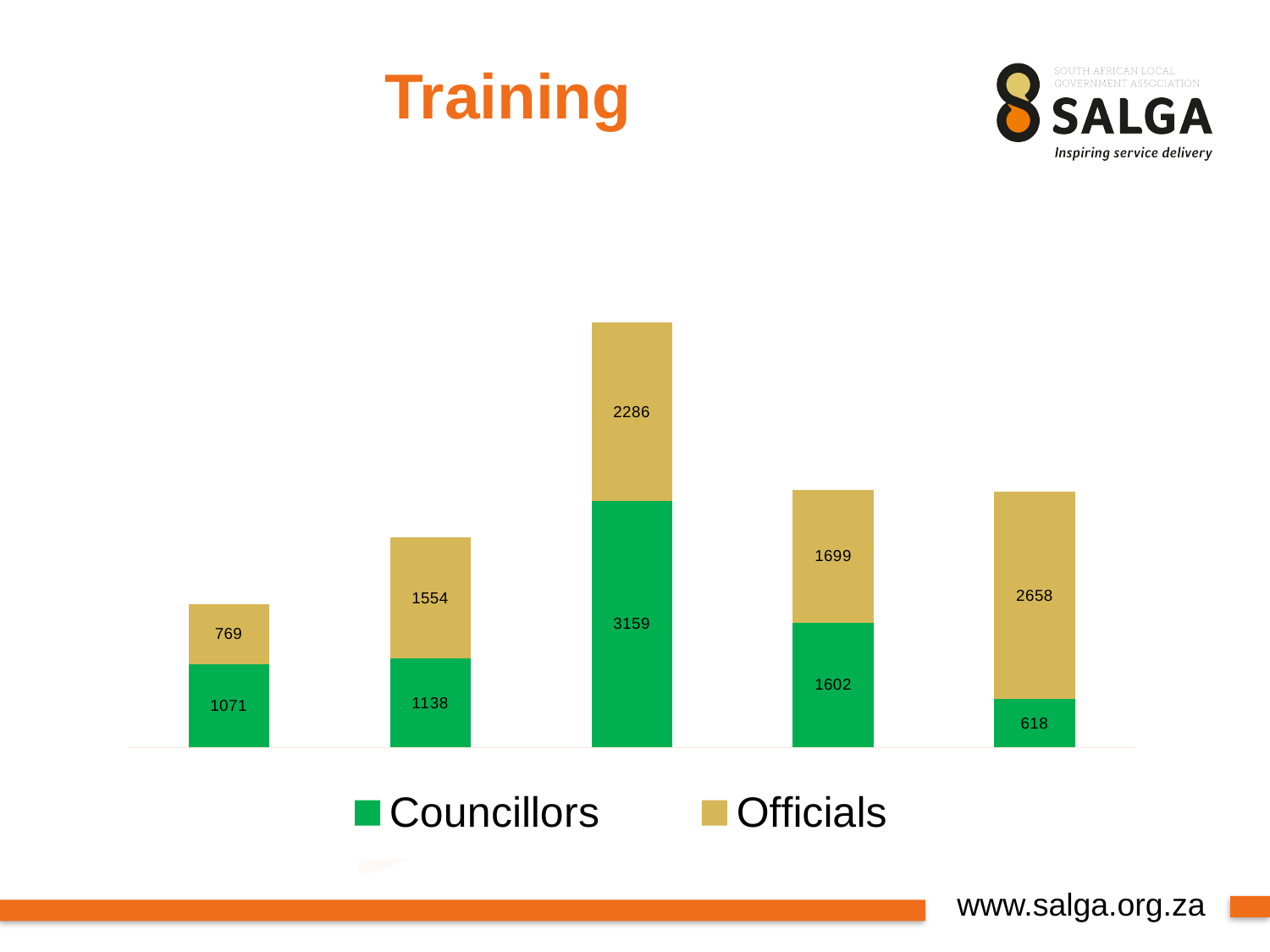
What is the Councillors value for the first (leftmost) bar? 1071 What is the total of the third stacked bar? 5445 How many stacked bars are shown in the chart? 5 Which bar, by position from the left, has the lowest Officials value? the first bar How many series does the legend list? 2 In the fourth bar, which is larger, the Councillors value or the Officials value? Officials Which bar, by position from the left, has the highest Councillors value? the third bar What is the Officials value for the third bar? 2286 What kind of chart is shown on the slide? stacked bar chart What is the total of the first (leftmost) stacked bar? 1840 What is the difference between the Councillors value and the Officials value in the third bar? 873 What is the Officials value for the fifth (rightmost) bar? 2658